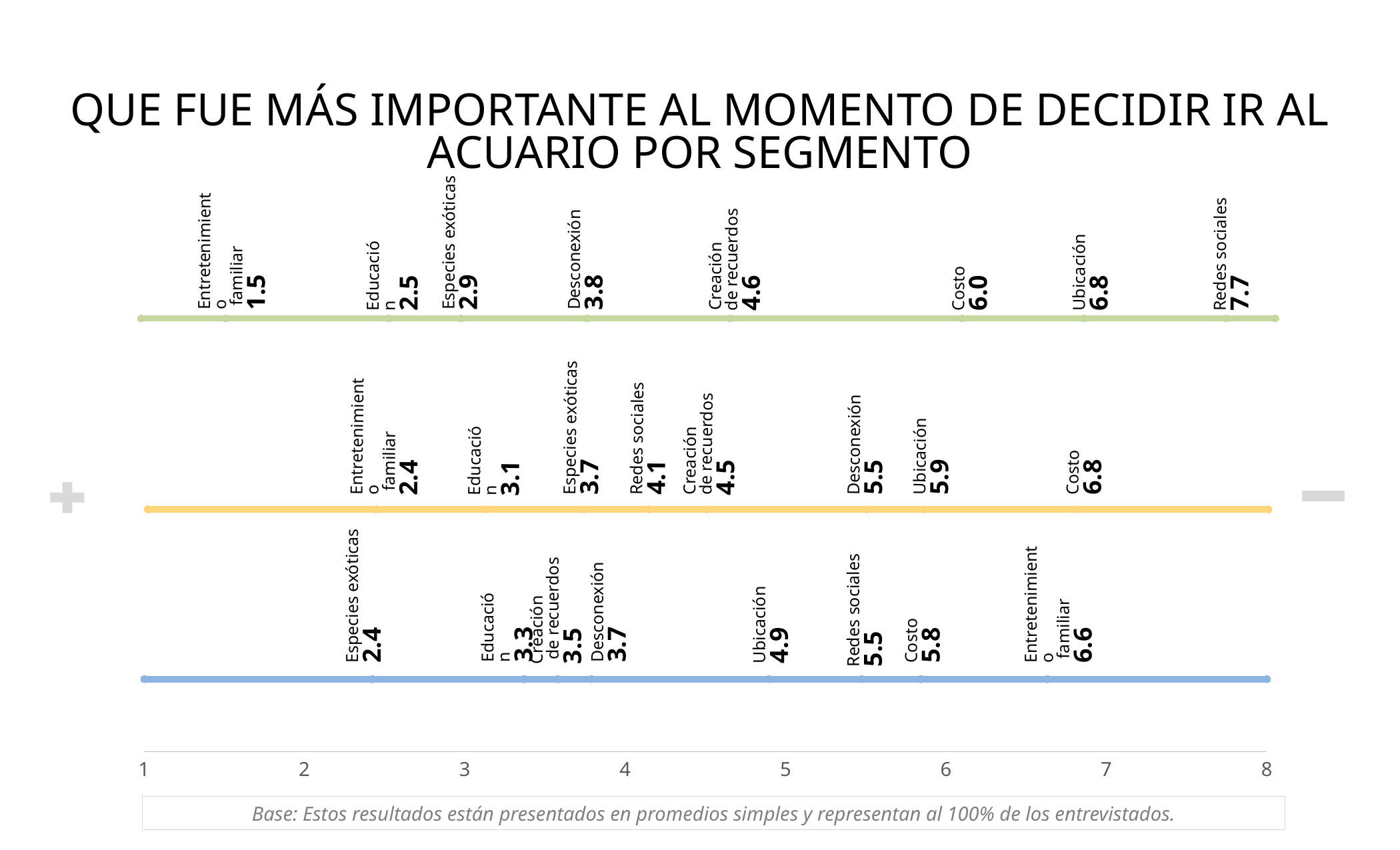
What is the highest value shown on the x axis of the chart? 8 On the middle (yellow) line, what is the value for Costo? 6.8 On the top (green) line, what is the value for Redes sociales? 7.7 On the bottom (blue) line, which category has the highest value? Entretenimiento familiar On the top (green) line, which category has the lowest value? Entretenimiento familiar How many horizontal lines (segments) are plotted on the chart? 3 On the bottom (blue) line, what is the difference between Costo and Especies exóticas? 3.4 Which is larger: Desconexión on the middle (yellow) line or Desconexión on the bottom (blue) line? Desconexión on the middle (yellow) line On the top (green) line, what is the difference between Redes sociales and Entretenimiento familiar? 6.2 On the middle (yellow) line, which category has the lowest value? Entretenimiento familiar How many categories are plotted on the top (green) line? 8 On the bottom (blue) line, what is the value for Ubicación? 4.9